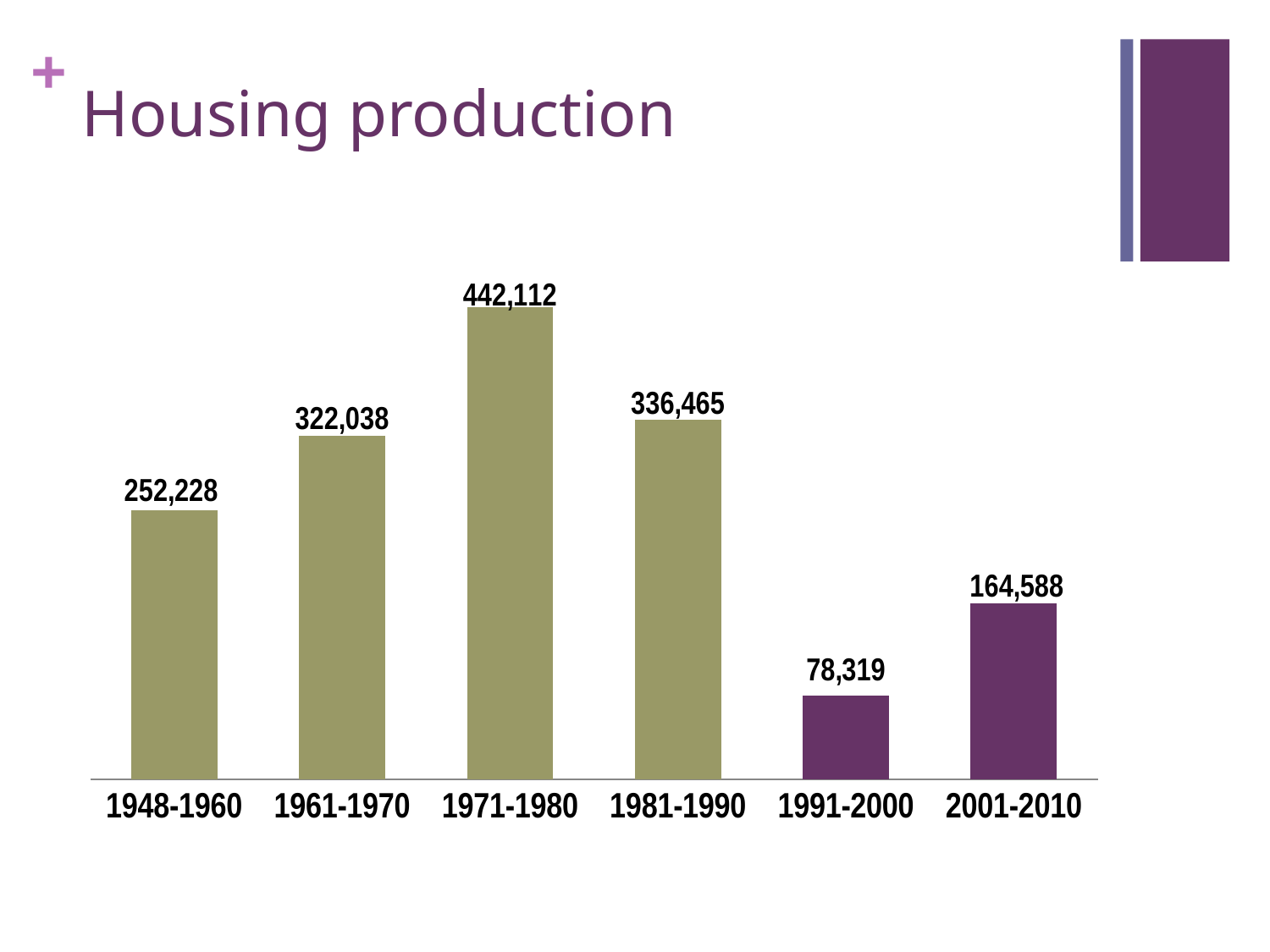
What is the housing production value for 1991-2000? 78,319 Which period has higher housing production, 1961-1970 or 1981-1990? 1981-1990 What is the title of the slide containing the chart? Housing production What kind of chart is shown on the slide? Bar chart What is the difference in housing production between 2001-2010 and 1991-2000? 86,269 How many periods are shown on the chart? 6 Which period has the highest housing production? 1971-1980 What is the housing production value for 1971-1980? 442,112 Does housing production rise or fall from 1981-1990 to 1991-2000? Fall What is the housing production value for 1948-1960? 252,228 What is the difference in housing production between 1971-1980 and 1981-1990? 105,647 Which period has the lowest housing production? 1991-2000